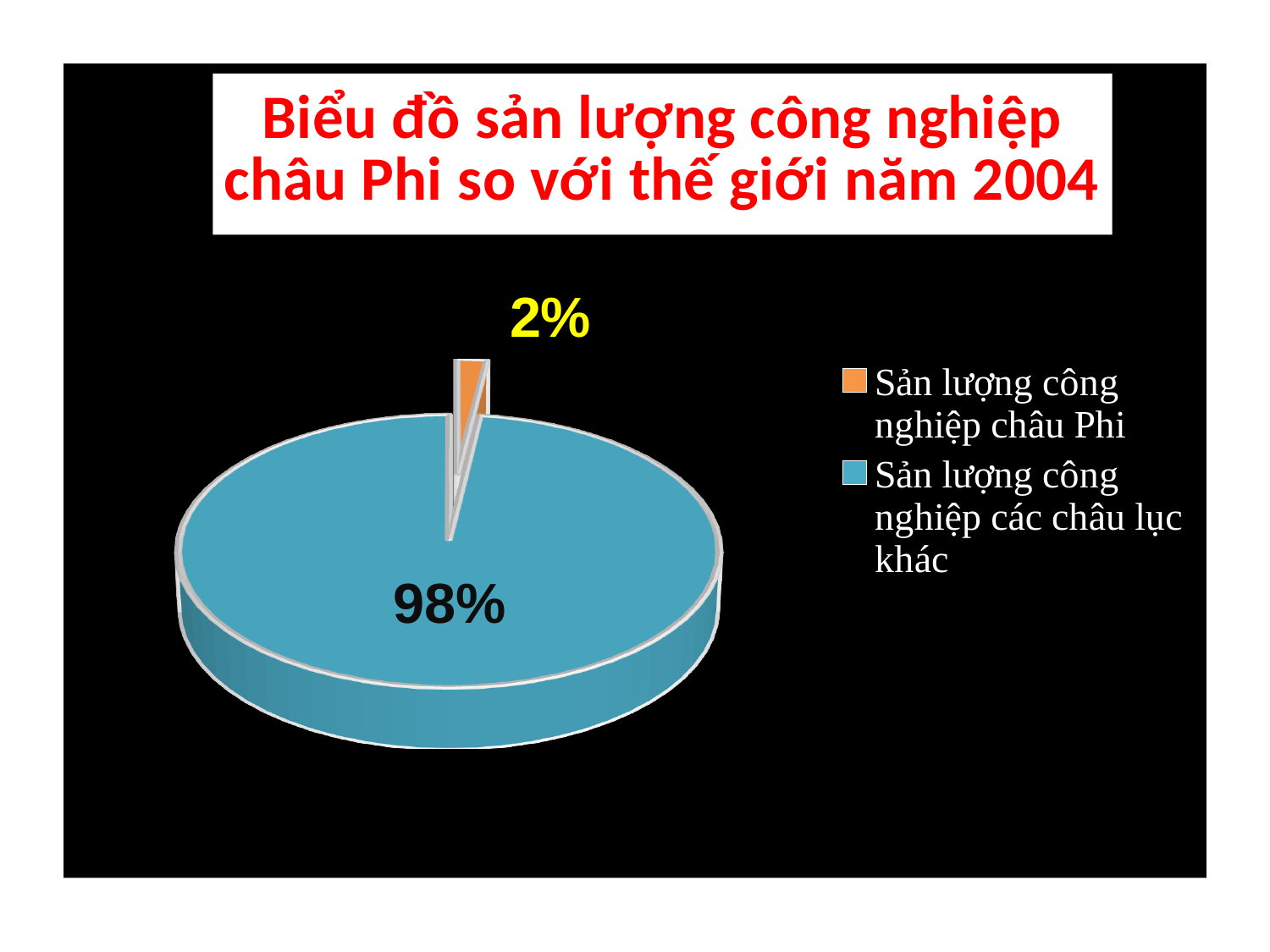
Which slice of the pie is the smallest? Sản lượng công nghiệp châu Phi What is the value shown for the orange slice of the pie? 2% Which slice of the pie is the largest? Sản lượng công nghiệp các châu lục khác How many slices does the pie chart have? 2 What is the difference in percentage points between the two slices of the pie? 96 What kind of chart is shown on the slide? pie chart What share of the pie does "Sản lượng công nghiệp các châu lục khác" represent? 98% How many entries does the legend list? 2 What share of the pie does "Sản lượng công nghiệp châu Phi" represent? 2% Which is larger: the share for "Sản lượng công nghiệp châu Phi" or the share for "Sản lượng công nghiệp các châu lục khác"? Sản lượng công nghiệp các châu lục khác What is the title of the chart? Biểu đồ sản lượng công nghiệp châu Phi so với thế giới năm 2004 What colour is the slice for "Sản lượng công nghiệp châu Phi"? orange